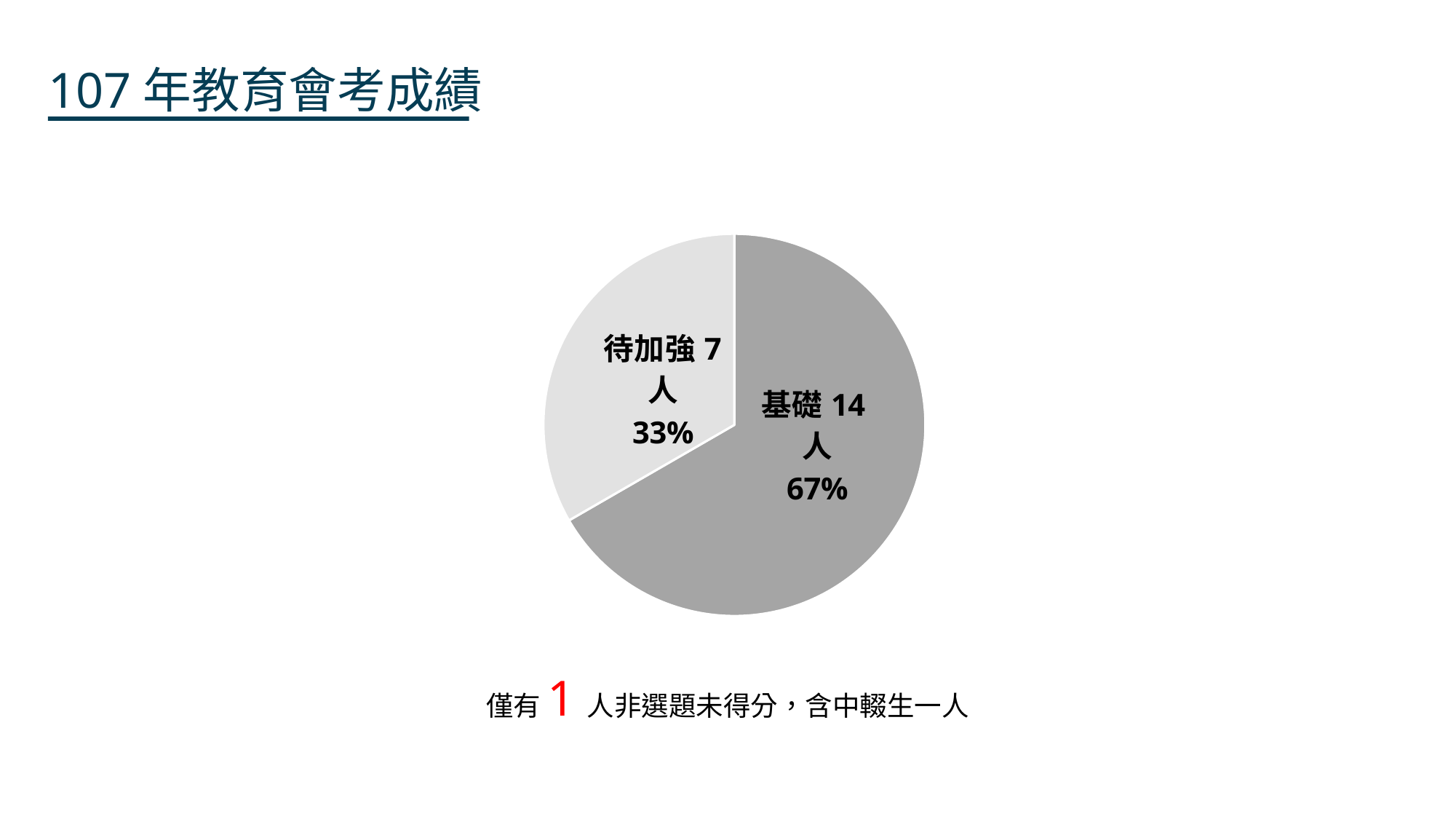
Which is larger, the 基礎 slice or the 待加強 slice? 基礎 Which category has the smallest slice? 待加強 What is the total number of people across both slices? 21 What share of the pie does the 基礎 slice represent? 67% How many people are in the 基礎 category? 14 人 How many slices does the pie chart have? 2 How many people are in the 待加強 category? 7 人 What kind of chart is shown on the slide? pie chart What is the title of the slide containing the pie chart? 107 年教育會考成績 Which category has the largest slice? 基礎 What share of the pie does the 待加強 slice represent? 33% How many more people are in 基礎 than in 待加強? 7